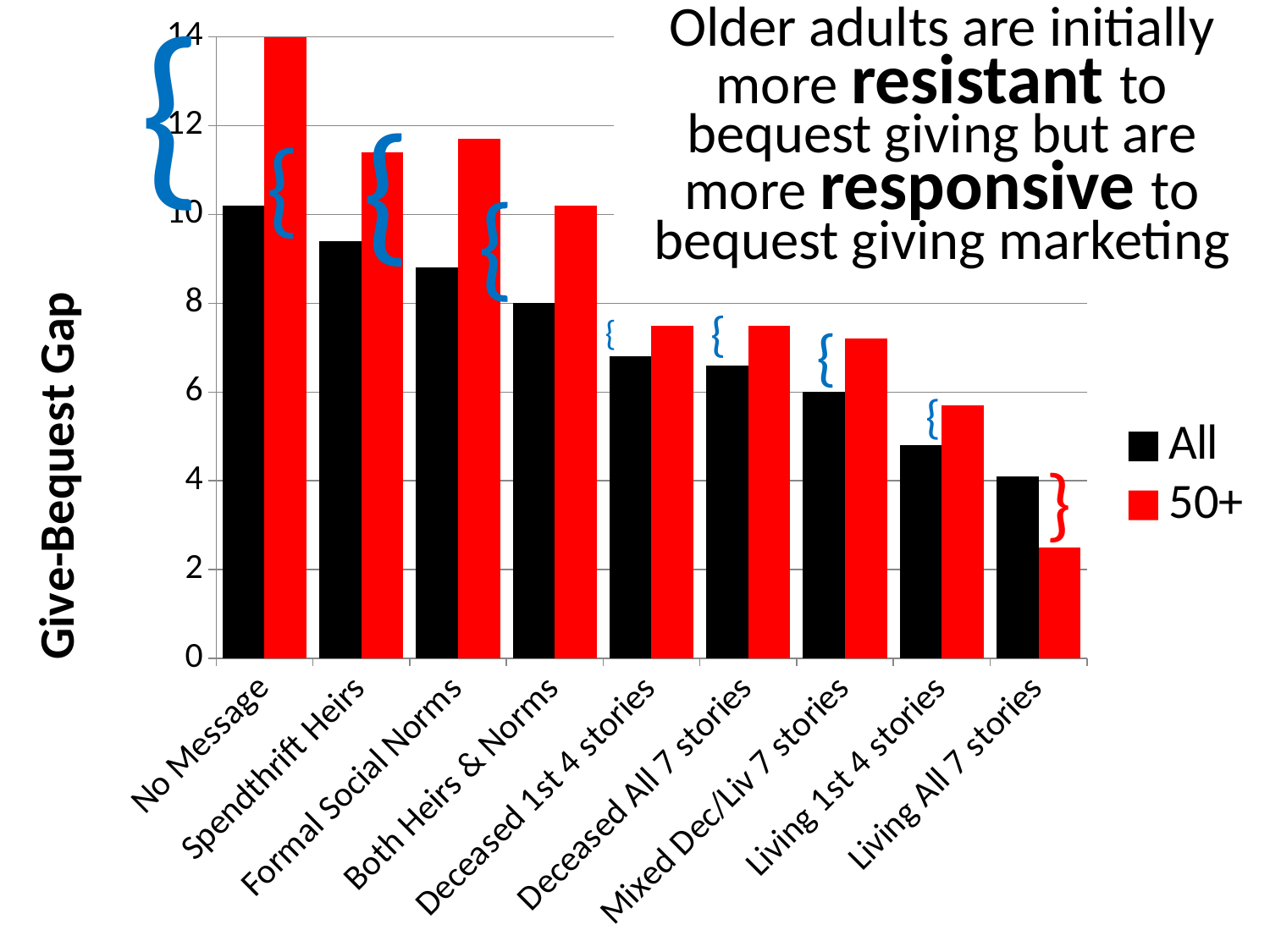
For Living All 7 stories, which series has the larger value, All or 50+? All Which category has the lowest value for the 50+ series? Living All 7 stories Do the All series values generally rise or fall from left to right along the x axis? fall Which category has the lowest value for the All series? Living All 7 stories What is the title of the vertical axis? Give-Bequest Gap Which category has the highest value for the 50+ series? No Message For No Message, which series has the larger value, All or 50+? 50+ What kind of chart is shown on the slide? bar chart How many categories are shown on the x axis? 9 How many series does the legend list? 2 Is the 50+ value for Living All 7 stories greater or less than 4? less Is the 50+ value for No Message greater or less than 12? greater